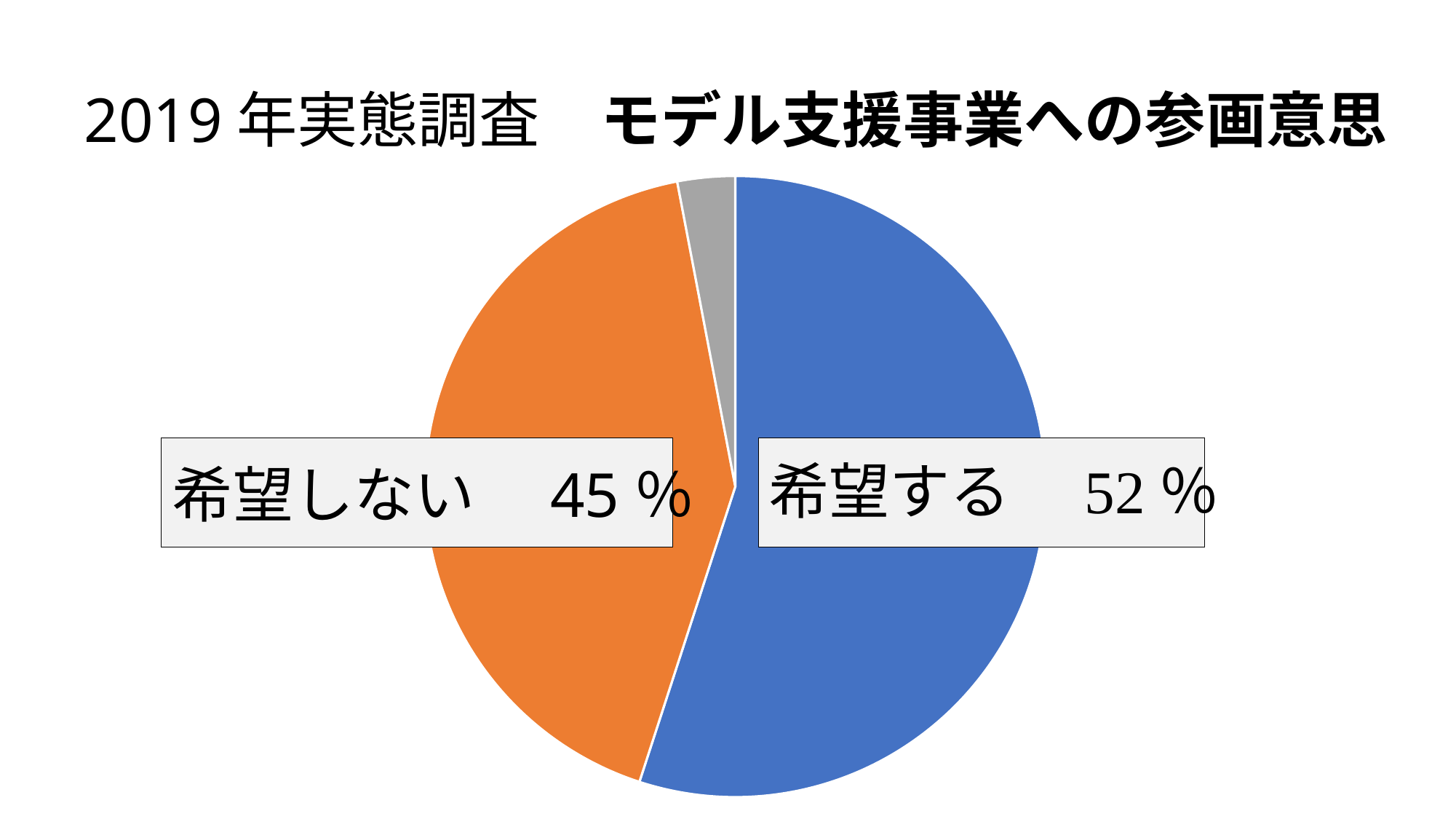
Which labelled category has the largest share of the pie? 希望する What percentage of the pie is labelled 希望しない? 45% What percentage of the pie is labelled 希望する? 52% What colour is the 希望しない slice? orange What share of the pie does the 希望する slice represent? 52% How many slices does the pie chart have? 3 What colour is the 希望する slice? blue What kind of chart is shown on the slide? pie chart By how many percentage points does 希望する exceed 希望しない? 7 percentage points Which is larger, the share for 希望する or the share for 希望しない? 希望する